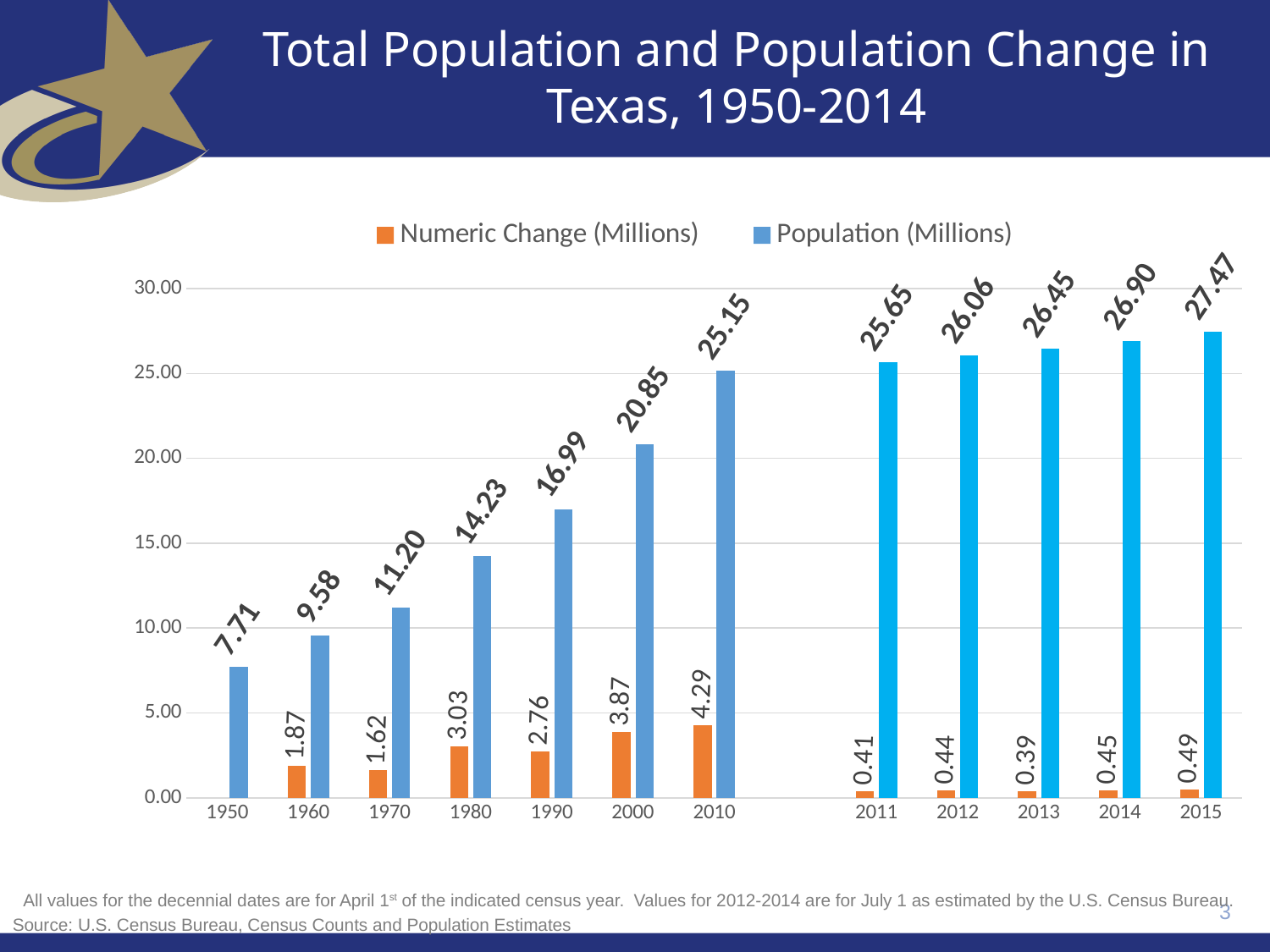
How many series does the legend list? 2 What is the difference between the Population (Millions) values for 2015 and 2010? 2.32 What is the Population (Millions) value for 2010? 25.15 Which year has the lowest Numeric Change (Millions) value among those labelled? 2013 What is the Numeric Change (Millions) value for 1980? 3.03 What kind of chart is shown on the slide? Bar chart How many years are shown on the x axis? 12 What is the Numeric Change (Millions) value for 2013? 0.39 Which year has the highest Population (Millions) value? 2015 Which year has the highest Numeric Change (Millions) value? 2010 Which is larger, the Numeric Change (Millions) for 1960 or for 1970? 1960 What is the Population (Millions) value for 1950? 7.71